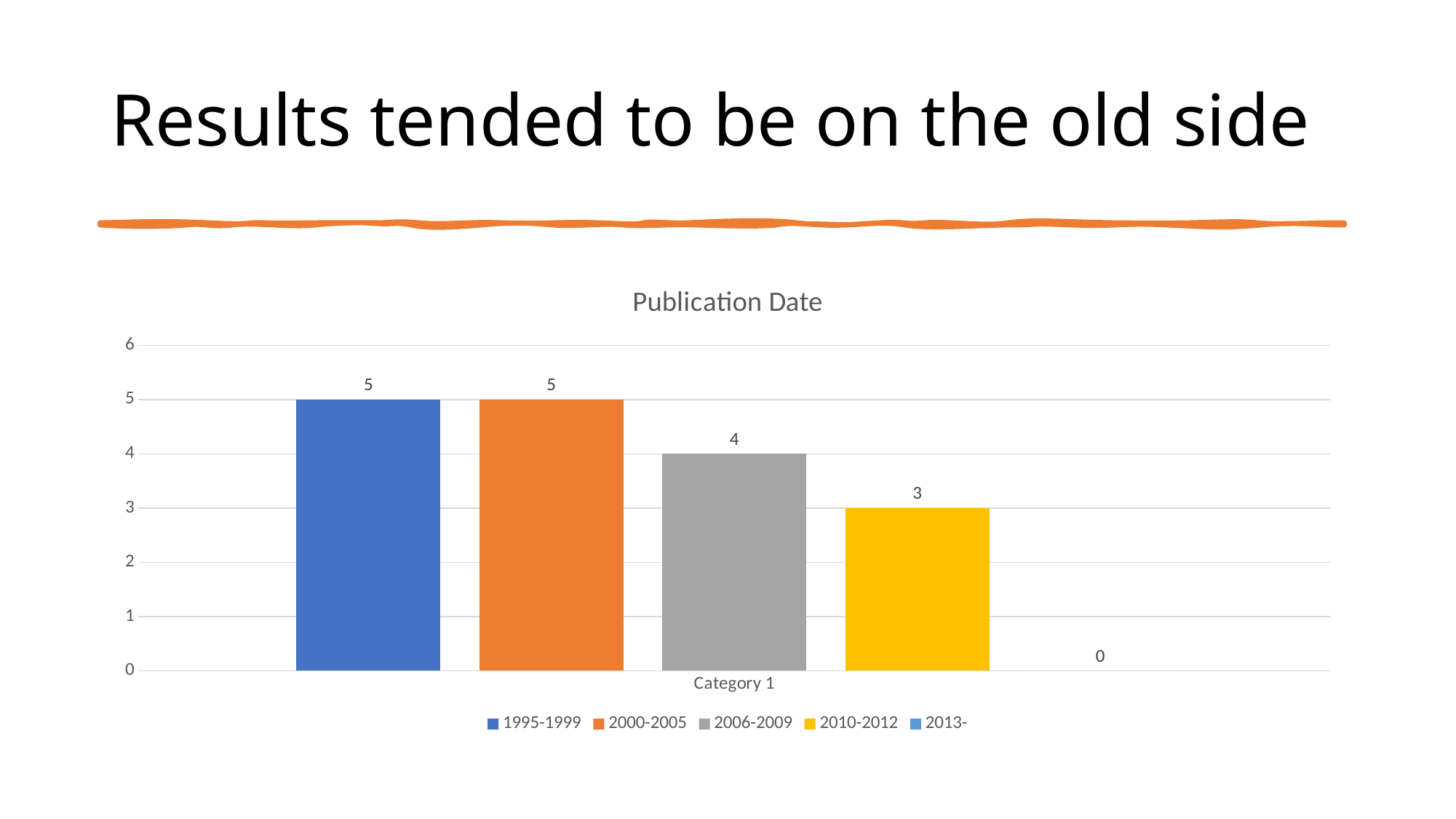
What is the value for the 1995-1999 series? 5 What is the value for the 2006-2009 series? 4 What is the value for the 2010-2012 series? 3 What kind of chart is shown on the slide? bar chart What is the difference between the values for 2000-2005 and 2010-2012? 2 What is the difference between the values for 2006-2009 and 2013-? 4 Do the values rise or fall from the 1995-1999 series to the 2013- series? fall What is the value for the 2013- series? 0 Which is larger, the value for 2006-2009 or the value for 2010-2012? 2006-2009 How many series does the legend list? 5 What is the title of the chart? Publication Date Which series has the lowest value? 2013-